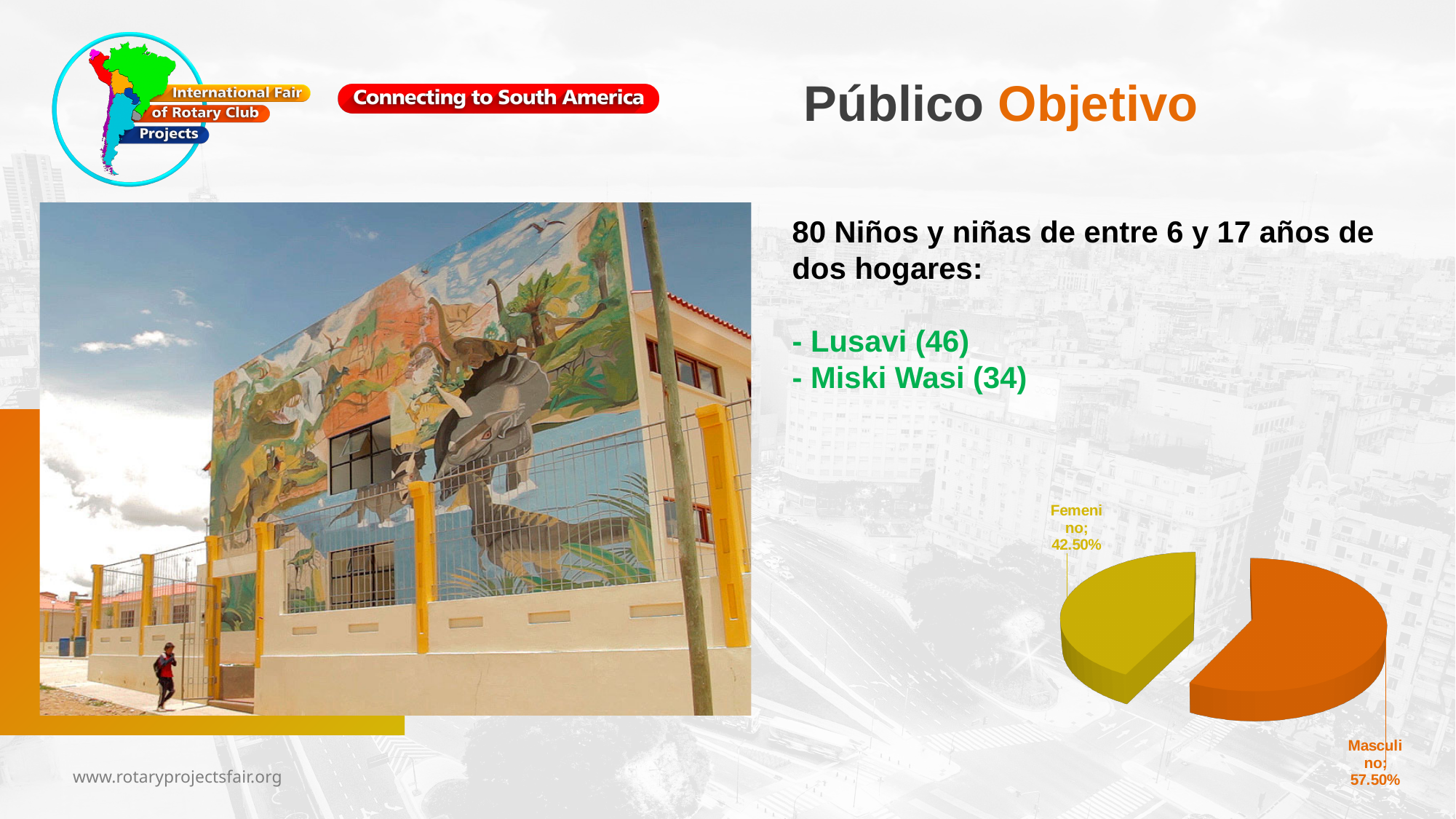
What colour is the Femenino slice of the pie chart? yellow Which slice of the pie chart is the smallest? Femenino What share of the pie chart is Masculino? 57.50% What kind of chart is shown on the slide? pie chart How many slices does the pie chart have? 2 Which slice of the pie chart is the largest? Masculino Is the Masculino share of the pie chart greater or less than 50%? greater Which is larger in the pie chart, Femenino or Masculino? Masculino What share of the pie chart is Femenino? 42.50% Is the Femenino share of the pie chart greater or less than 50%? less What colour is the Masculino slice of the pie chart? orange What is the difference in percentage points between the Masculino and Femenino slices? 15 percentage points